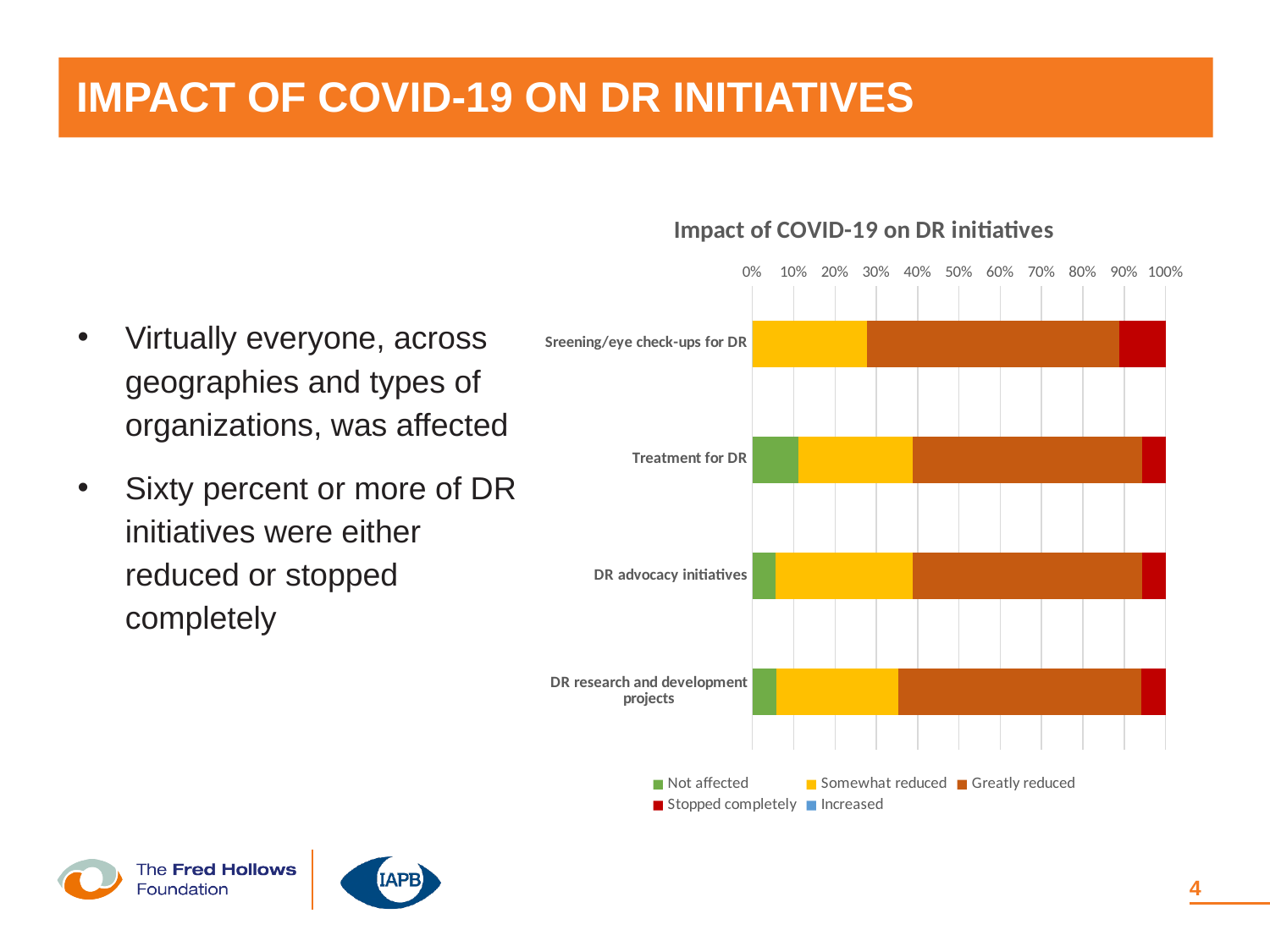
How many DR initiative categories are plotted on the chart? 4 Is the 'Somewhat reduced' share for Sreening/eye check-ups for DR greater or less than 40%? less Which category has the largest 'Stopped completely' segment? Sreening/eye check-ups for DR What type of chart is shown on the slide? Stacked bar chart Is the 'Stopped completely' share for Sreening/eye check-ups for DR greater or less than 5%? greater Which legend series does not appear as a visible segment in any bar? Increased Is the 'Not affected' segment larger for Treatment for DR or for DR advocacy initiatives? Treatment for DR Which category has no 'Not affected' segment at all? Sreening/eye check-ups for DR Which category has the largest 'Not affected' segment? Treatment for DR What is the title of the chart? Impact of COVID-19 on DR initiatives Is the 'Not affected' share for Treatment for DR greater or less than 20%? less How many series does the chart legend list? 5